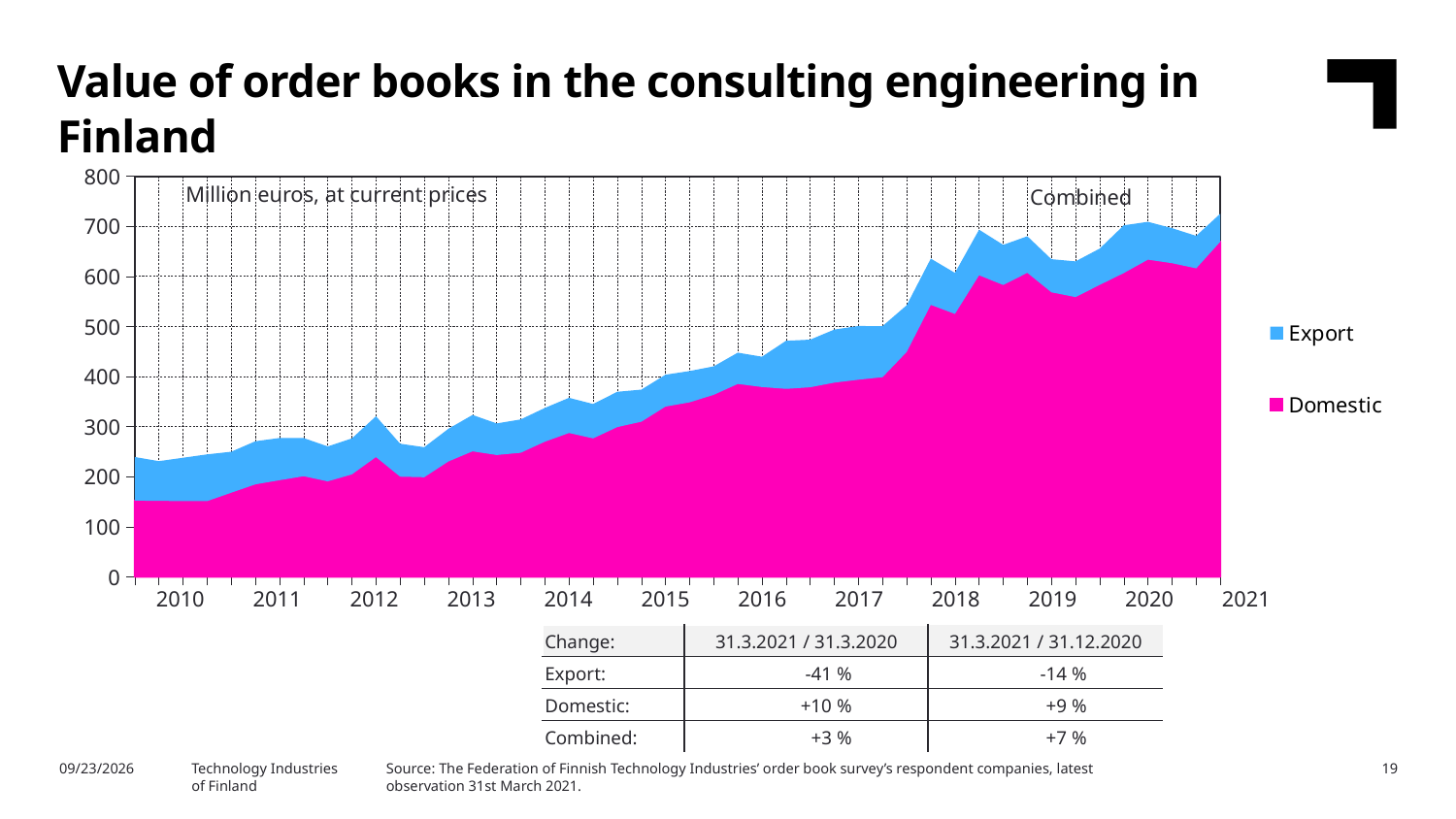
At the end of the series in 2021, which is larger, the Domestic or the Export portion? Domestic According to the table below the chart, what is the Export change for 31.3.2021 / 31.3.2020? -41 % How many series does the chart legend list? 2 How many year labels are shown on the x axis? 12 Which two series are listed in the chart legend? Export and Domestic What kind of chart is shown on the slide? Stacked area chart Is the Domestic value at the start of 2010 greater or less than 200? less Is the Domestic value at the end of the series in 2021 greater or less than 600? greater What unit is stated in the label at the top left of the chart? Million euros, at current prices Is the combined value of order books at the start of 2010 greater or less than 300? less Does the combined value of order books generally rise or fall from 2010 to 2021? rise